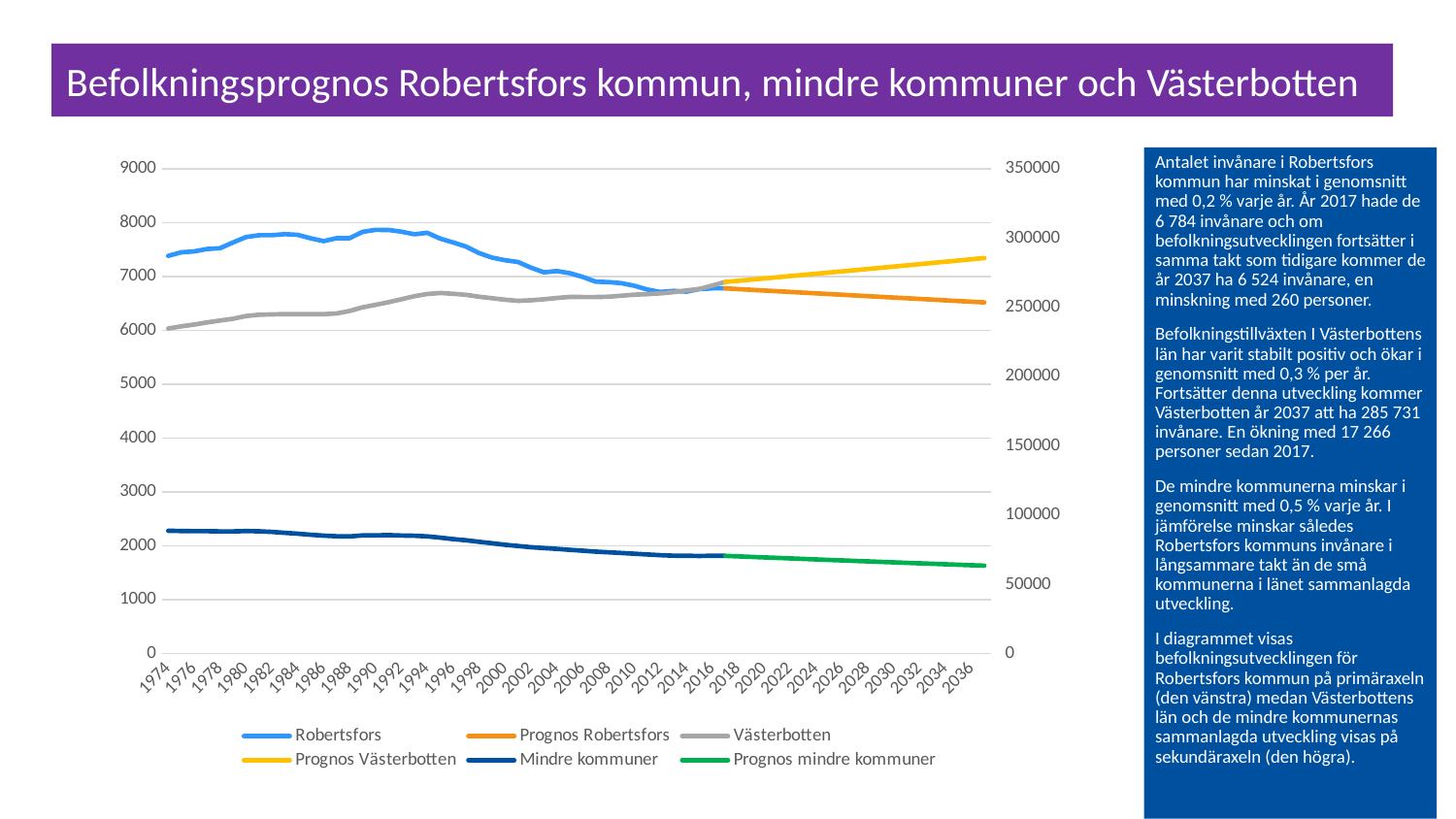
Is the value for Prognos Robertsfors in 2036 greater or less than 7000? less What is the title of the slide's chart? Befolkningsprognos Robertsfors kommun, mindre kommuner och Västerbotten Does the Mindre kommuner line rise or fall overall from 1974 to 2016? fall Which series is drawn in yellow? Prognos Västerbotten Does the Prognos Västerbotten line rise or fall from 2018 to 2036? rise What kind of chart is shown on the slide? line chart Is the value for Robertsfors in 1974 greater or less than 7000? greater How many series does the legend list? 6 Does the Robertsfors line rise or fall overall from 1974 to 2016? fall